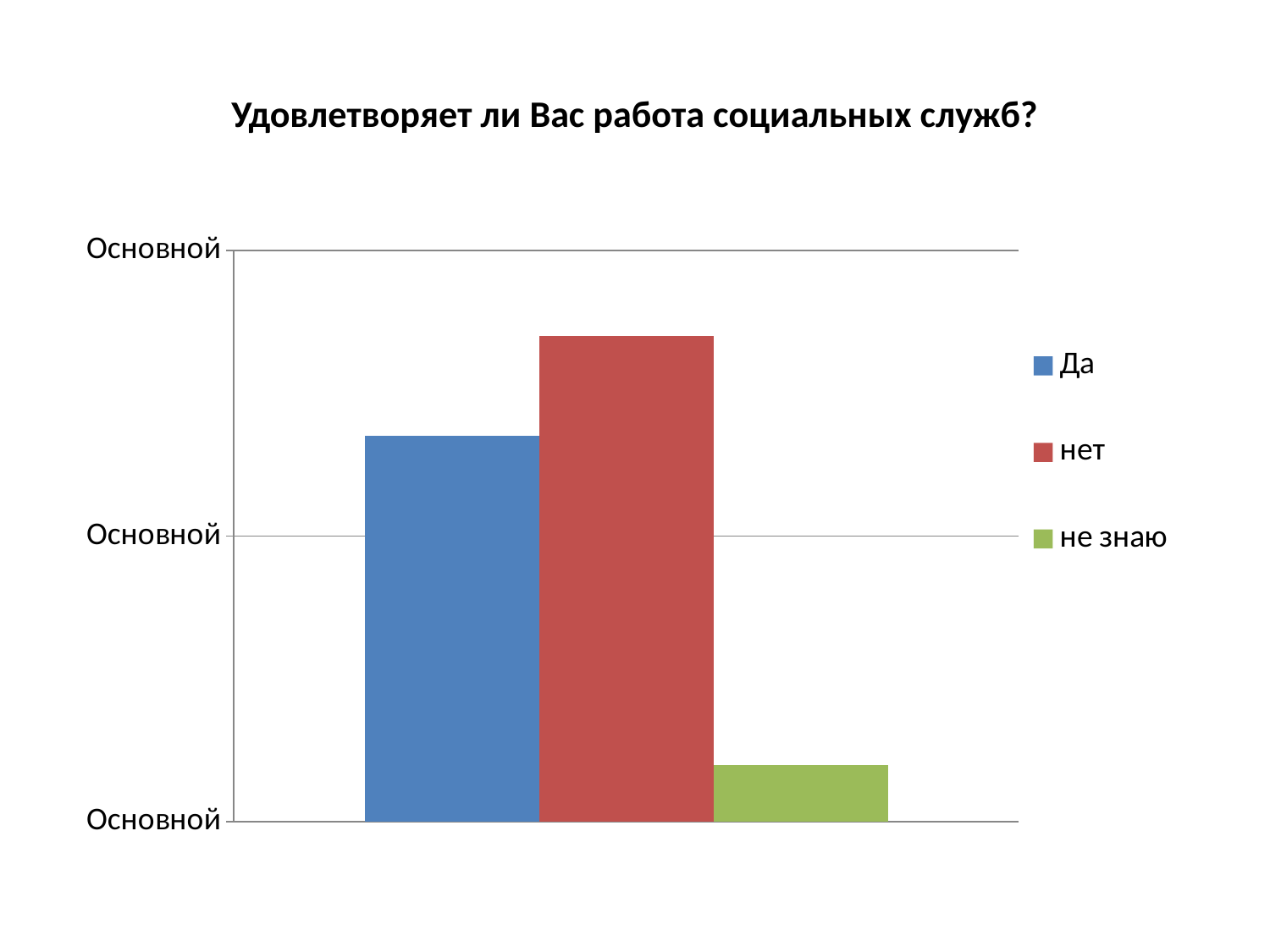
Which is larger, the bar for Да or the bar for нет? нет What is the title of the chart? Удовлетворяет ли Вас работа социальных служб? Which answer option has the highest bar? нет What colour is the bar for нет? red How many bars are plotted in the chart? 3 Which is larger, the bar for Да or the bar for не знаю? Да Which answer option has the lowest bar? не знаю What type of chart is shown on the slide? bar chart How many series does the legend list? 3